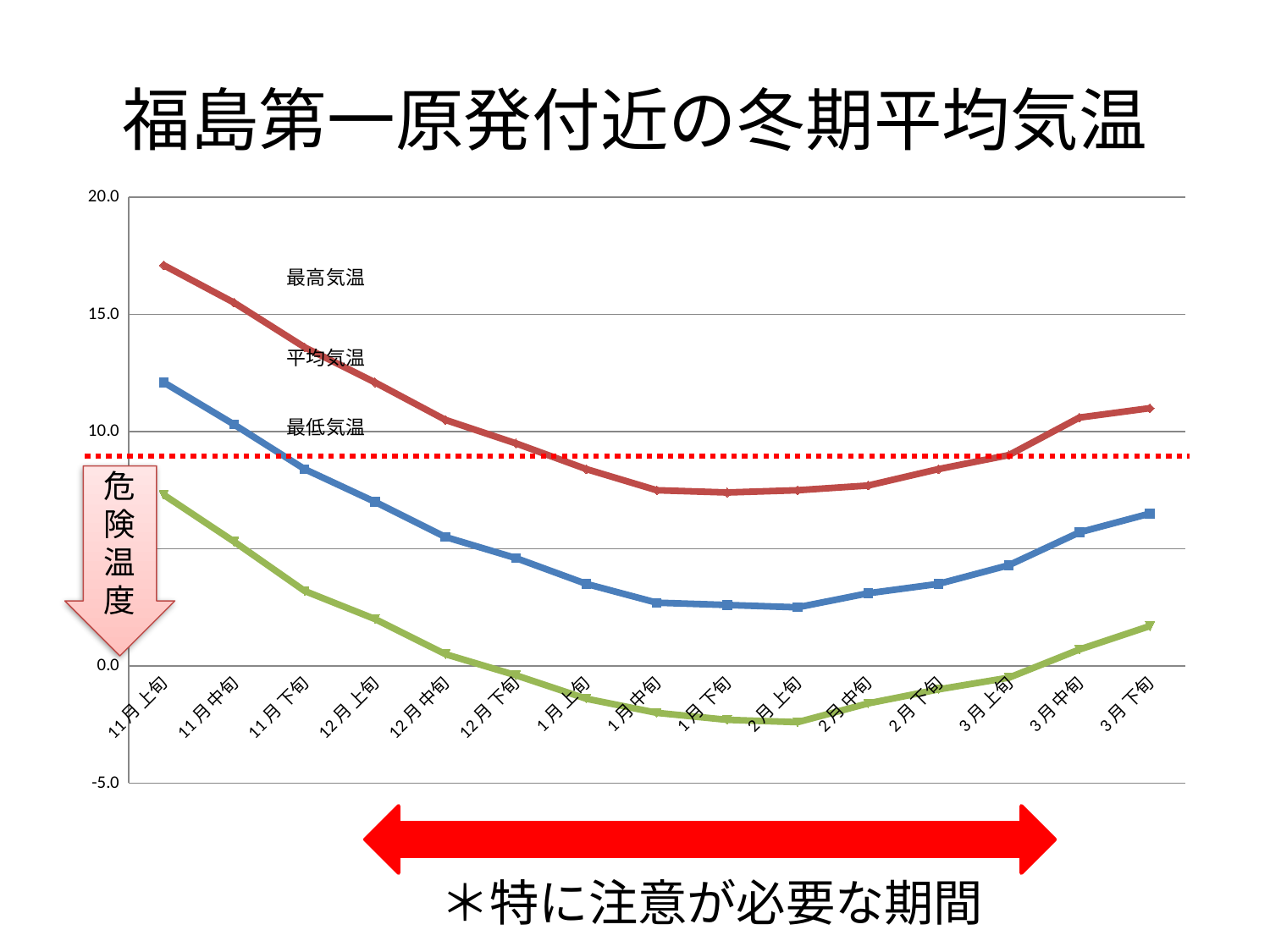
Is the 最高気温 value for 11月上旬 greater or less than 15.0? greater How many temperature series are plotted on the chart? 3 How many time periods are shown along the x axis? 15 What kind of chart is shown on the slide? line chart Which series is drawn in red? 最高気温 Is the 最高気温 value for 1月下旬 greater or less than 10.0? less Does the 平均気温 rise or fall from 11月上旬 to 2月上旬? fall Which is larger, the 最高気温 for 11月上旬 or for 3月下旬? 11月上旬 Is the 平均気温 value for 11月上旬 greater or less than 10.0? greater What is the title of the chart? 福島第一原発付近の冬期平均気温 In which period is the 平均気温 highest? 11月上旬